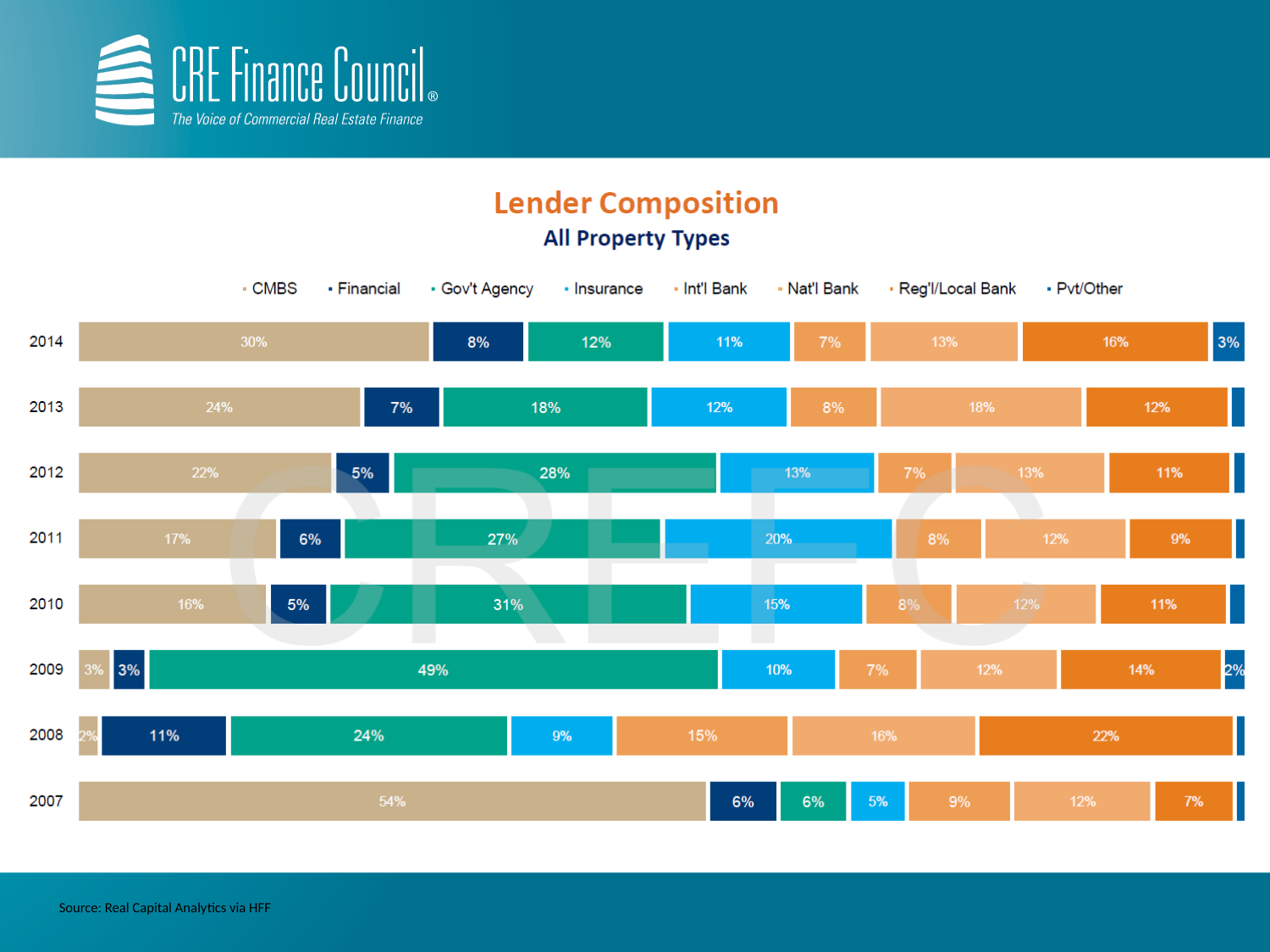
What share of lenders was CMBS in 2014? 30% How many lender types does the legend list? 8 In which year was the Gov't Agency share the lowest? 2007 What was the Reg'l/Local Bank share in 2008? 22% What type of chart is shown on the slide? Stacked bar chart What was the Gov't Agency share in 2009? 49% What is the subtitle of the chart? All Property Types What was the Insurance share in 2011? 20% What is the difference between the CMBS share in 2007 and in 2014? 24% In which year was the CMBS share the highest? 2007 Which was larger in 2013, the Gov't Agency share or the Insurance share? Gov't Agency How many years are shown on the chart? 8